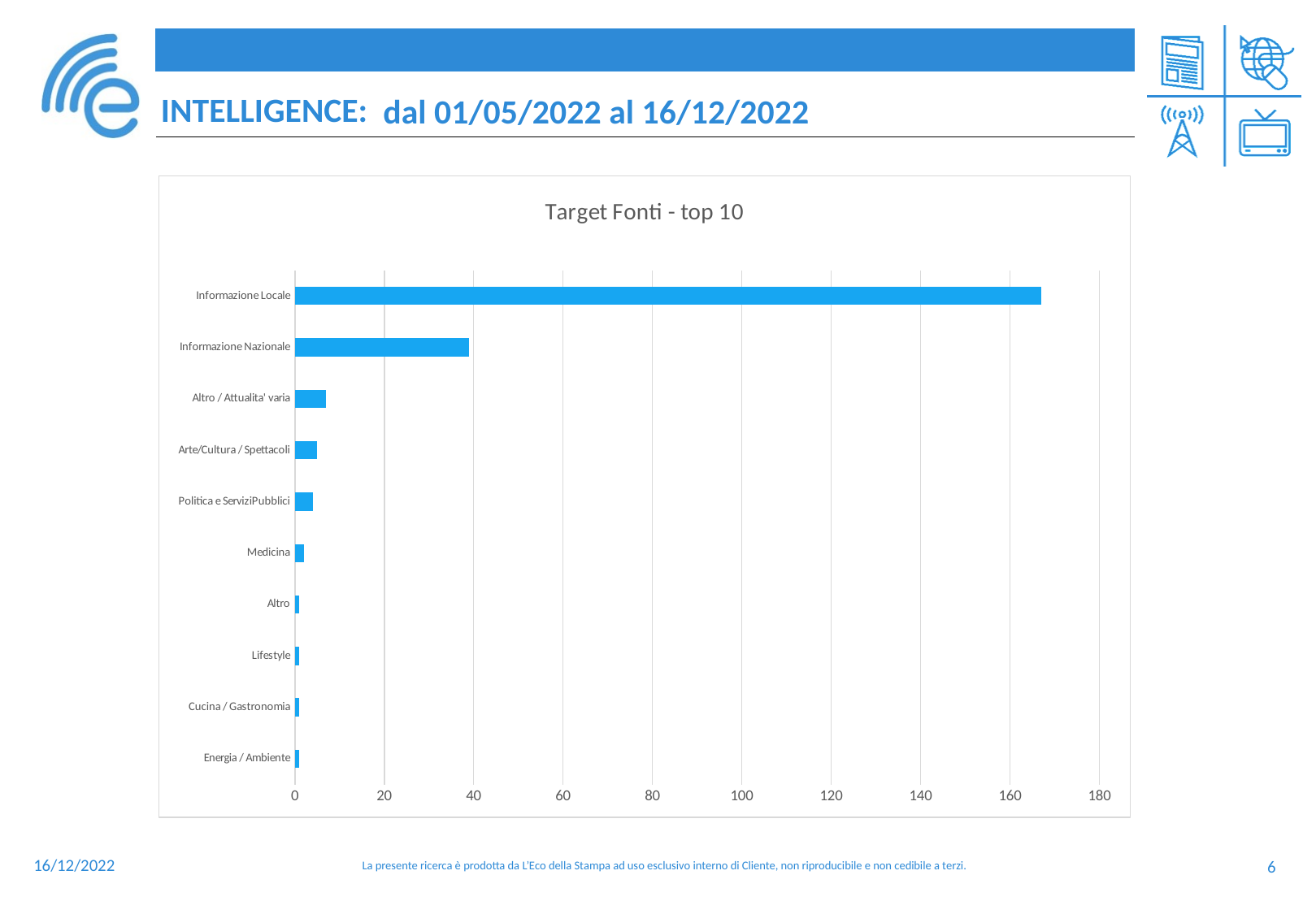
Which category has the highest value? Informazione Locale Is the value for Informazione Locale greater or less than 160? greater Is the value for Altro / Attualita' varia greater or less than 20? less Is the value for Informazione Nazionale greater or less than 20? greater What is the highest value shown on the horizontal axis? 180 Which is larger, the value for Altro / Attualita' varia or the value for Medicina? Altro / Attualita' varia What is the title of the chart? Target Fonti - top 10 What kind of chart is shown on the slide? bar chart Which is larger, the value for Informazione Nazionale or the value for Arte/Cultura / Spettacoli? Informazione Nazionale How many categories are plotted in the chart? 10